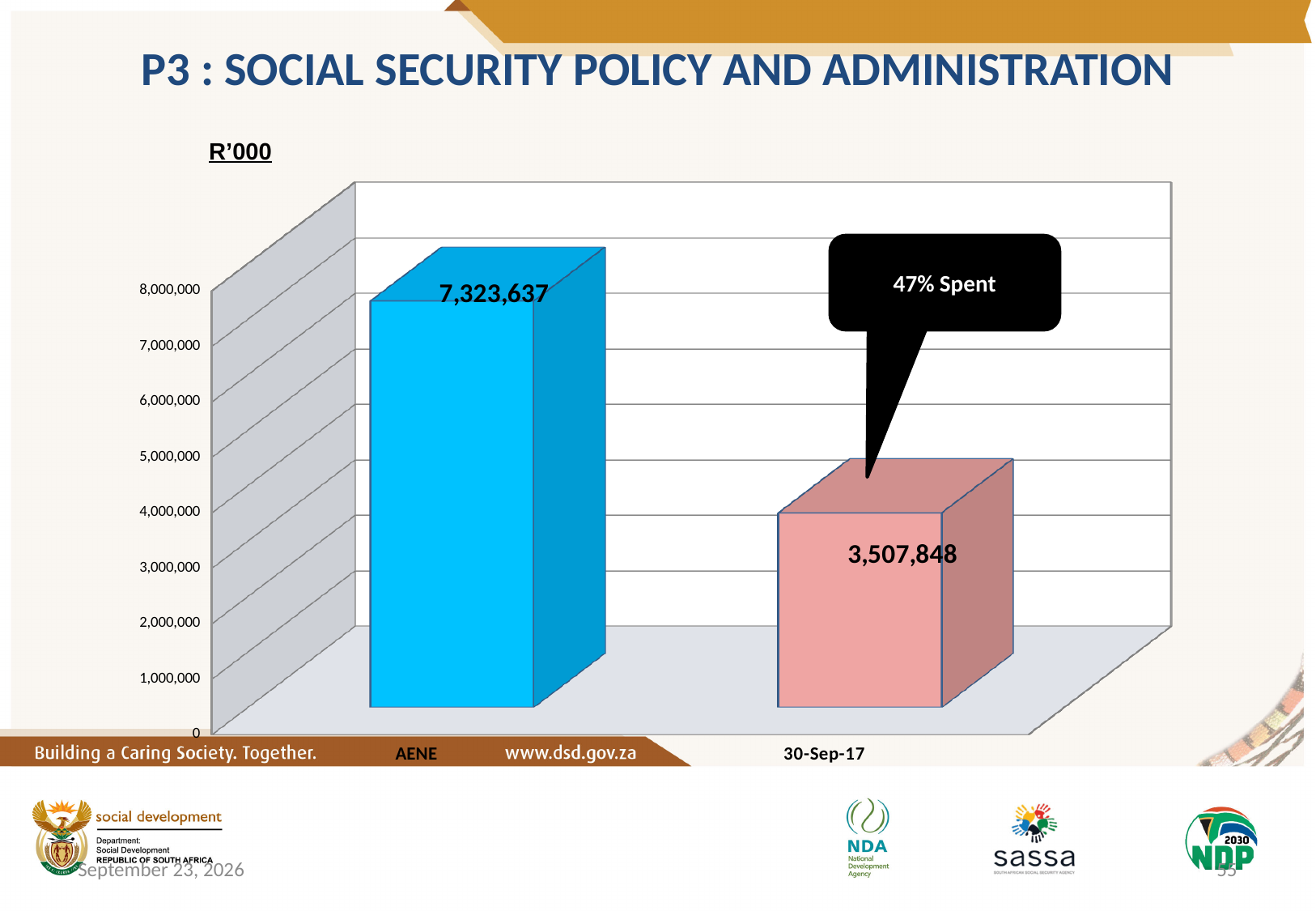
What unit label is shown above the chart? R'000 Which is larger, the AENE value or the 30-Sep-17 value? AENE Is the value for AENE greater or less than 7,000,000? greater Is the value for 30-Sep-17 greater or less than 4,000,000? less Which category has the highest value? AENE Which category has the lowest value? 30-Sep-17 What is the value of the AENE bar? 7,323,637 What is the value of the 30-Sep-17 bar? 3,507,848 What percentage spent does the callout on the chart state? 47% Spent What kind of chart is shown on the slide? Bar chart What is the difference between the AENE value and the 30-Sep-17 value? 3,815,789 How many bars are plotted on the chart? 2